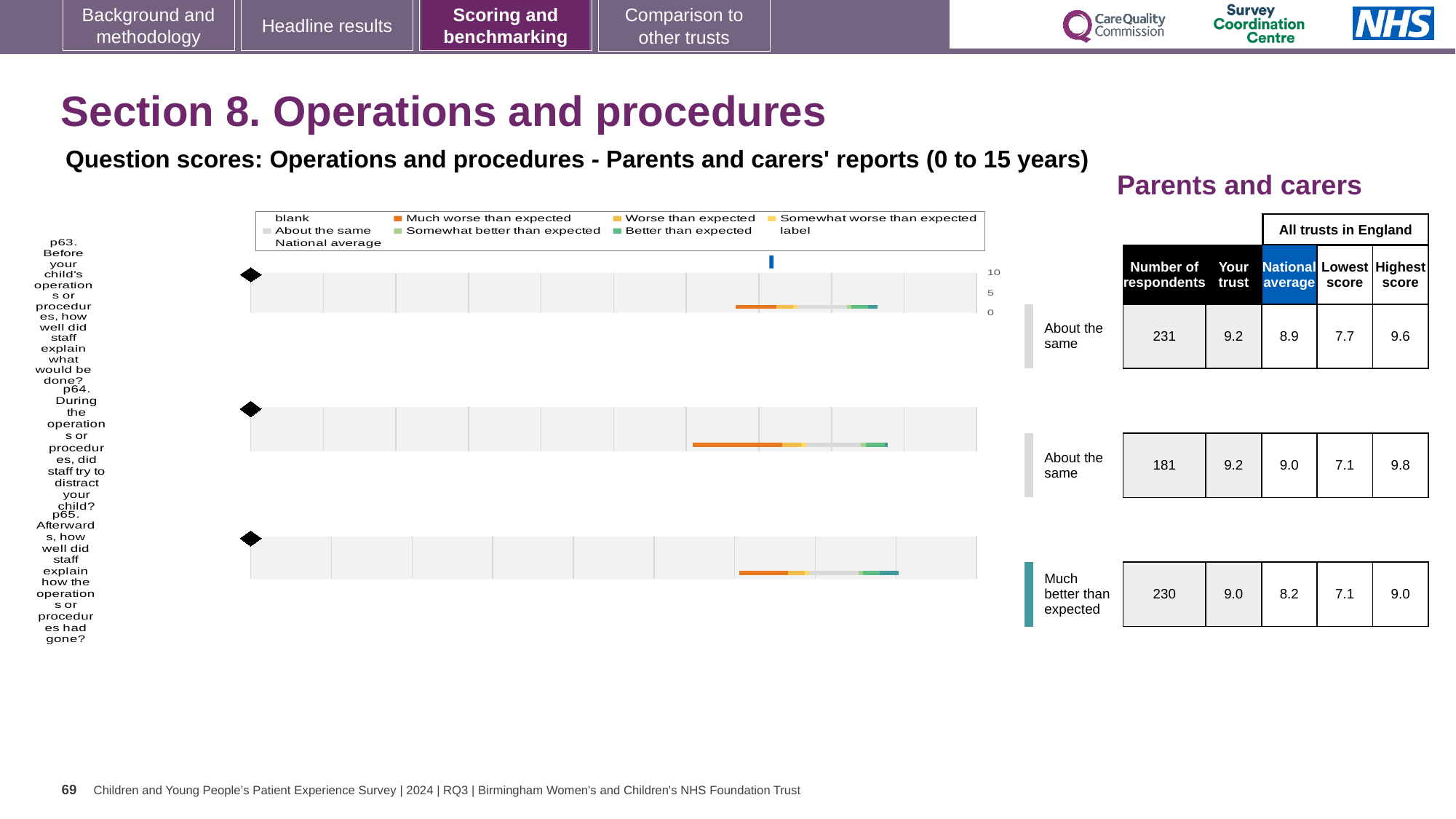
Which colour does the legend use for 'Much worse than expected'? Orange What kind of chart is used to show the question scores for Operations and procedures? Bar chart Is the 'Your trust' score higher for p63 or for p65? p63 Which question has the lowest national average score? p65 What is the lowest score across all trusts in England for p63? 7.7 What is the difference between the 'Your trust' score and the national average for p65? 0.8 How many questions (p63, p64, p65) are plotted in the chart? 3 What is the national average score for p64 (did staff try to distract your child during the operation)? 9.0 What benchmark category is shown for p65? Much better than expected How many respondents answered p65 (how well staff explained how the operation had gone)? 230 What is the 'Your trust' score for p63 (how well staff explained what would be done before the operation)? 9.2 Which question has the highest 'Highest score' across all trusts in England? p64